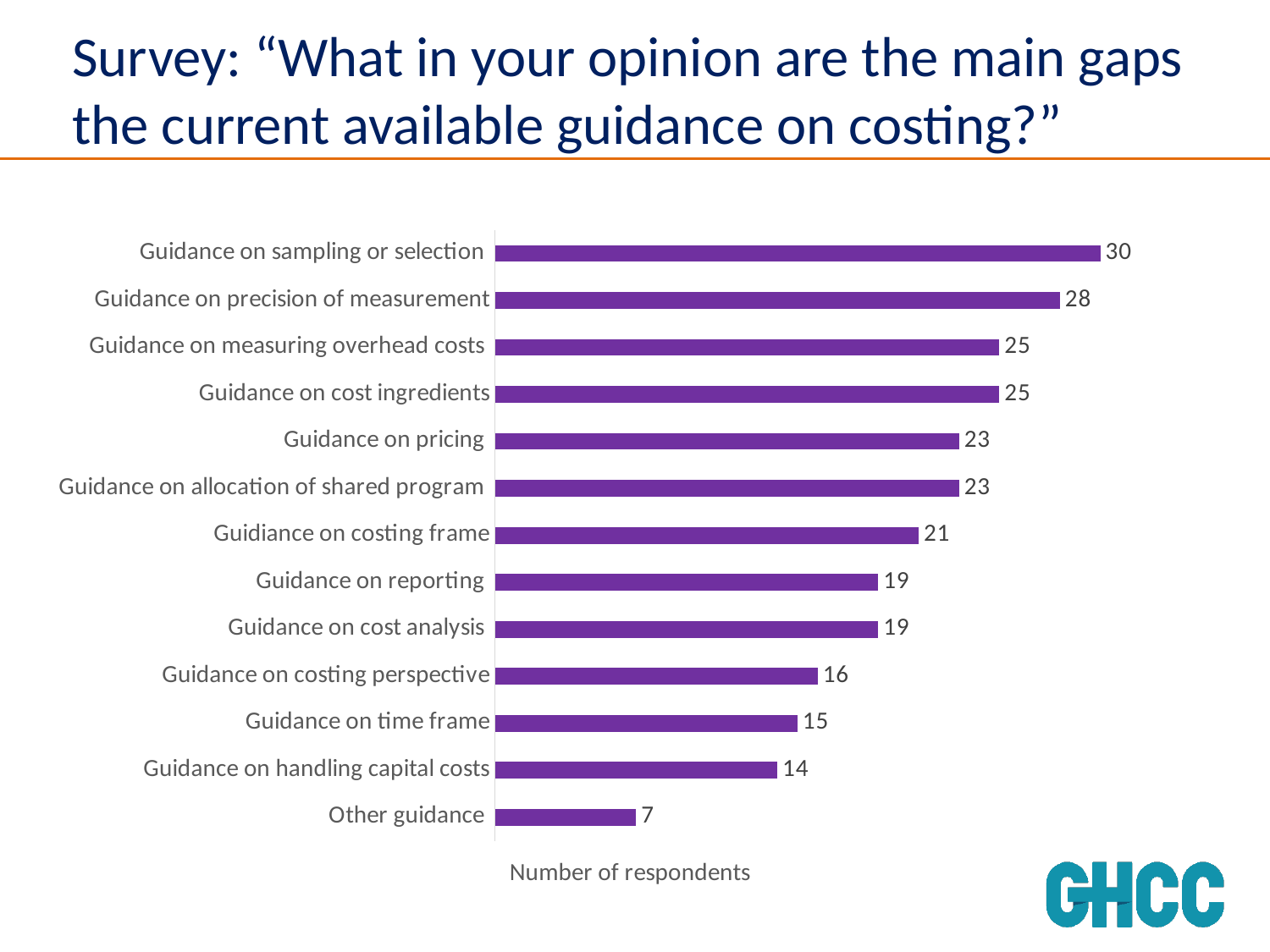
What is the label below the chart describing the values? Number of respondents What is the number of respondents for Guidance on sampling or selection? 30 Which category has the highest number of respondents? Guidance on sampling or selection What is the difference in respondents between Guidance on sampling or selection and Guidance on precision of measurement? 2 Which has more respondents, Guidance on time frame or Guidance on costing perspective? Guidance on costing perspective What kind of chart is shown on the slide? Bar chart Which category has the lowest number of respondents? Other guidance How many categories are shown in the chart? 13 What is the number of respondents for Guidance on handling capital costs? 14 How many categories have exactly 25 respondents? 2 What is the difference in respondents between Guidance on pricing and Other guidance? 16 What is the number of respondents for Guidance on costing frame? 21